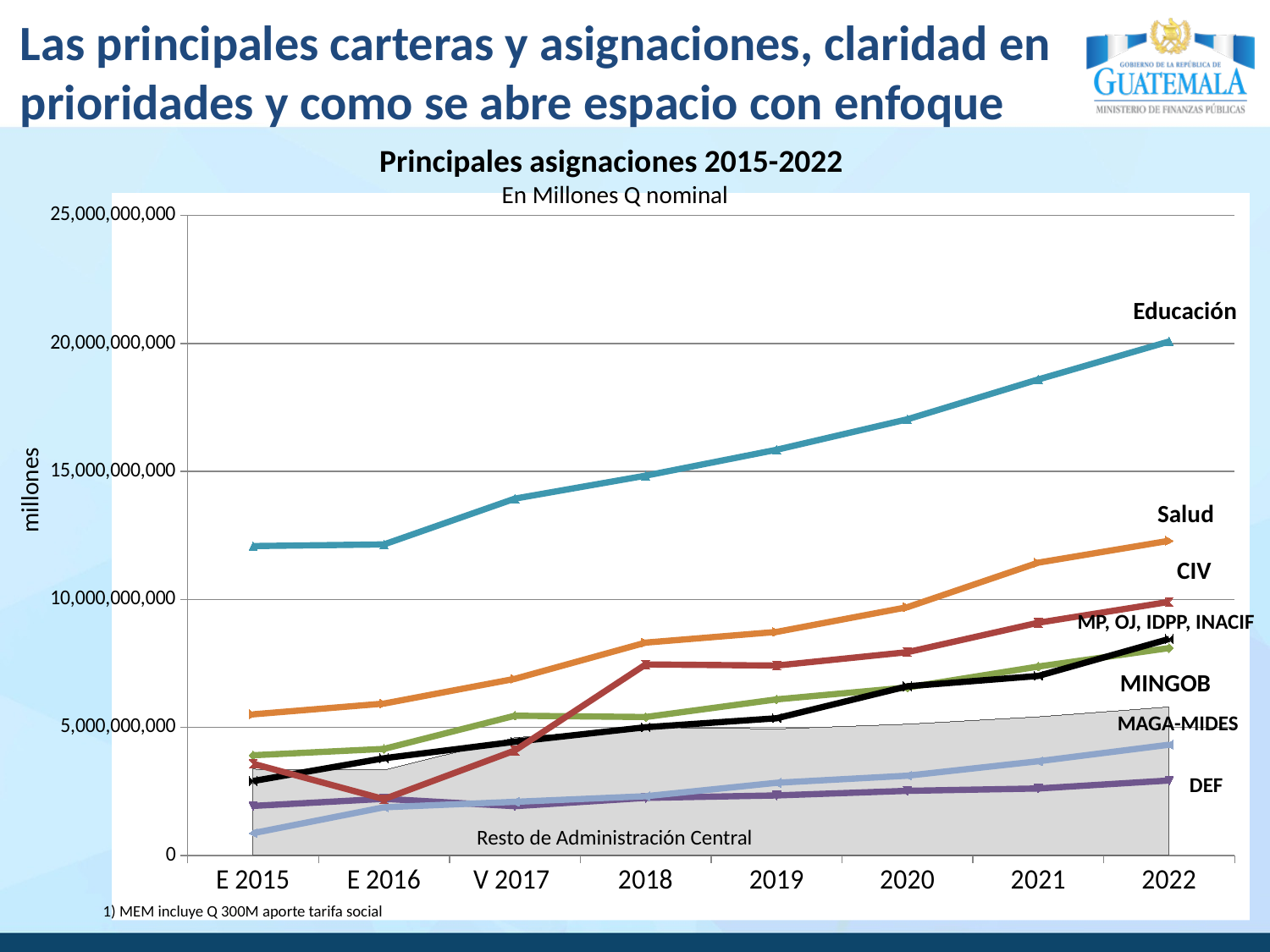
Is the value for DEF in 2022 greater or less than 5,000,000,000? less In 2022, which is larger: Salud or CIV? Salud What kind of chart is shown on the slide? combination area and line chart (lines with a shaded area) Is the value for Salud in 2022 greater or less than 10,000,000,000? greater Does the Educación line rise or fall from E 2015 to 2022? rise In 2022, which is larger: MINGOB or MAGA-MIDES? MINGOB Which series has the highest value in 2022? Educación Is the value for Educación in 2020 greater or less than 15,000,000,000? greater Which labelled line has the lowest value in 2022? DEF What is the title of the chart? Principales asignaciones 2015-2022 How many time points are shown on the x axis of the chart? 8